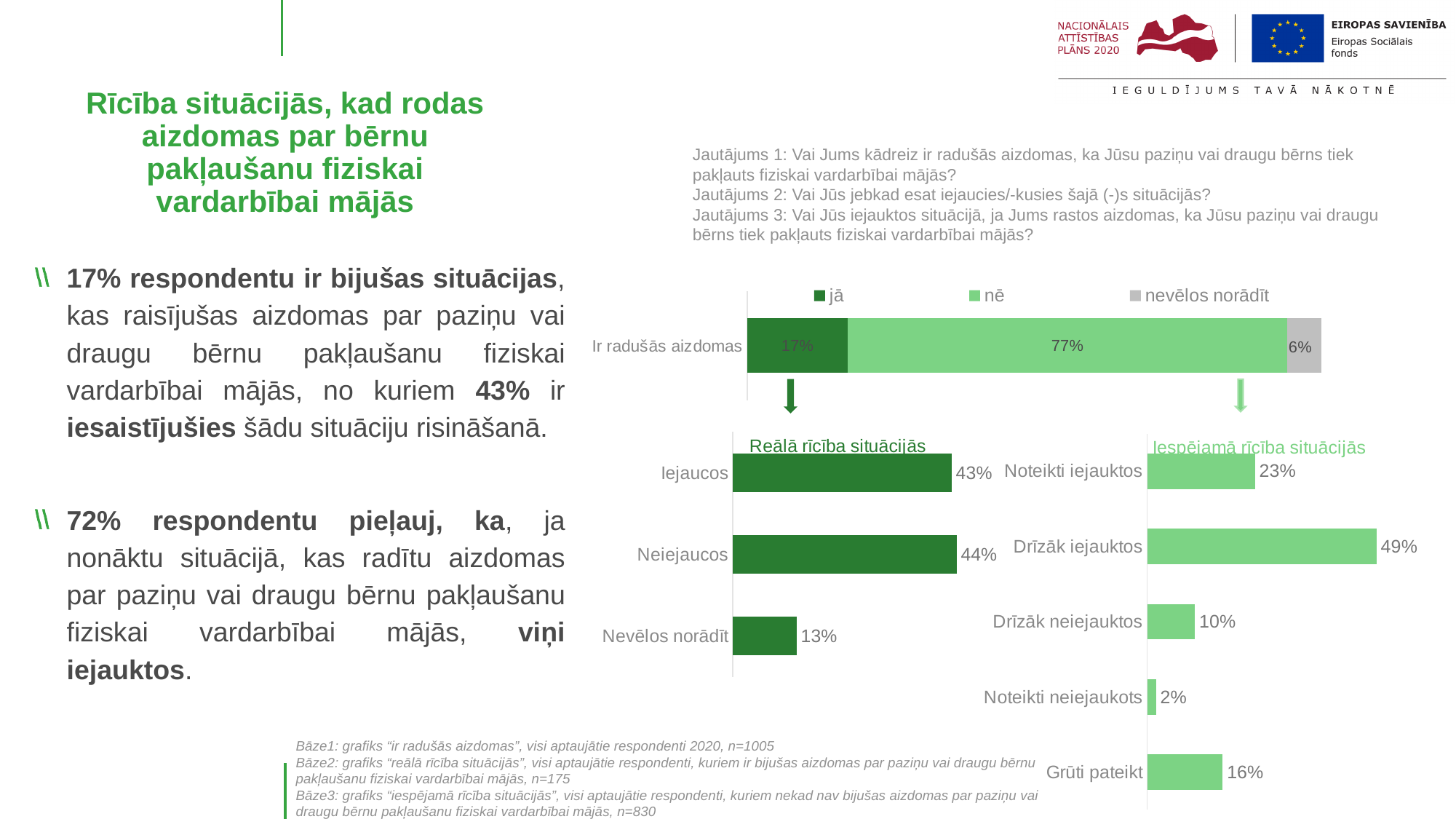
In the chart "Iespējamā rīcība situācijās", which category has the highest value? Drīzāk iejauktos In the top stacked bar chart "Ir radušās aizdomas", what is the total of the three segments? 100% In the chart "Iespējamā rīcība situācijās", what is the value for "Grūti pateikt"? 16% In the top stacked bar chart "Ir radušās aizdomas", what is the value for "nē"? 77% In the chart "Reālā rīcība situācijās", what is the difference between "Neiejaucos" and "Iejaucos"? 1% How many categories are shown in the chart "Reālā rīcība situācijās"? 3 In the chart "Iespējamā rīcība situācijās", which category has the lowest value? Noteikti neiejaukots How many series does the legend of the top stacked bar chart "Ir radušās aizdomas" list? 3 In the chart "Reālā rīcība situācijās", what is the value for "Nevēlos norādīt"? 13% In the chart "Iespējamā rīcība situācijās", which is larger: "Noteikti iejauktos" or "Drīzāk neiejauktos"? Noteikti iejauktos In the top stacked bar chart "Ir radušās aizdomas", what is the value for "jā"? 17% What kind of chart is "Iespējamā rīcība situācijās"? Bar chart